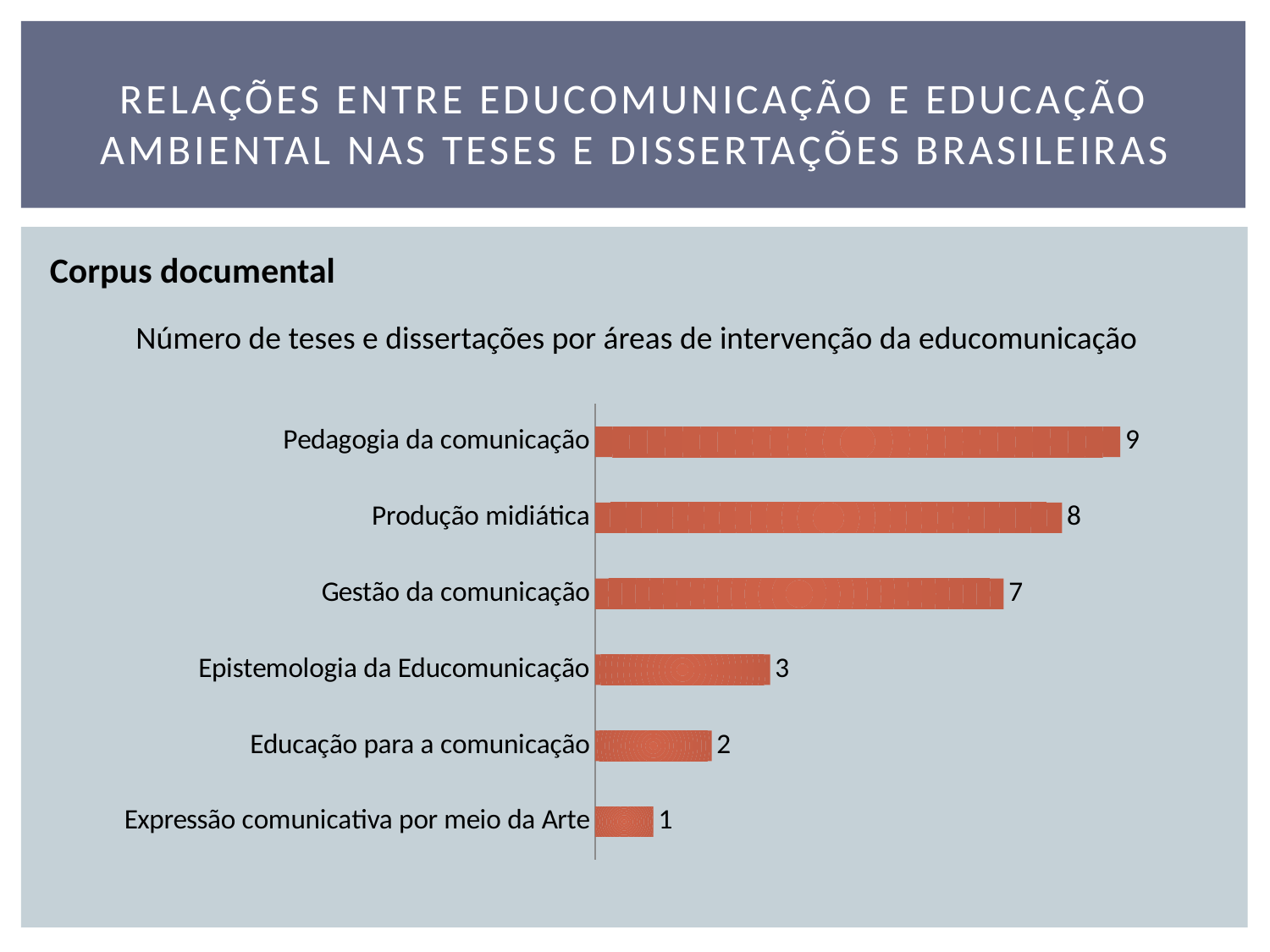
What kind of chart is shown on the slide? Bar chart Which category has the highest value? Pedagogia da comunicação What is the value for Pedagogia da comunicação? 9 What is the value for Epistemologia da Educomunicação? 3 What is the value for Produção midiática? 8 How many categories are shown in the chart? 6 Which is larger, the value for Gestão da comunicação or the value for Epistemologia da Educomunicação? Gestão da comunicação What is the difference between the values for Pedagogia da comunicação and Educação para a comunicação? 7 What is the title of the chart? Número de teses e dissertações por áreas de intervenção da educomunicação What is the value for Expressão comunicativa por meio da Arte? 1 What is the value for Gestão da comunicação? 7 Which category has the lowest value? Expressão comunicativa por meio da Arte